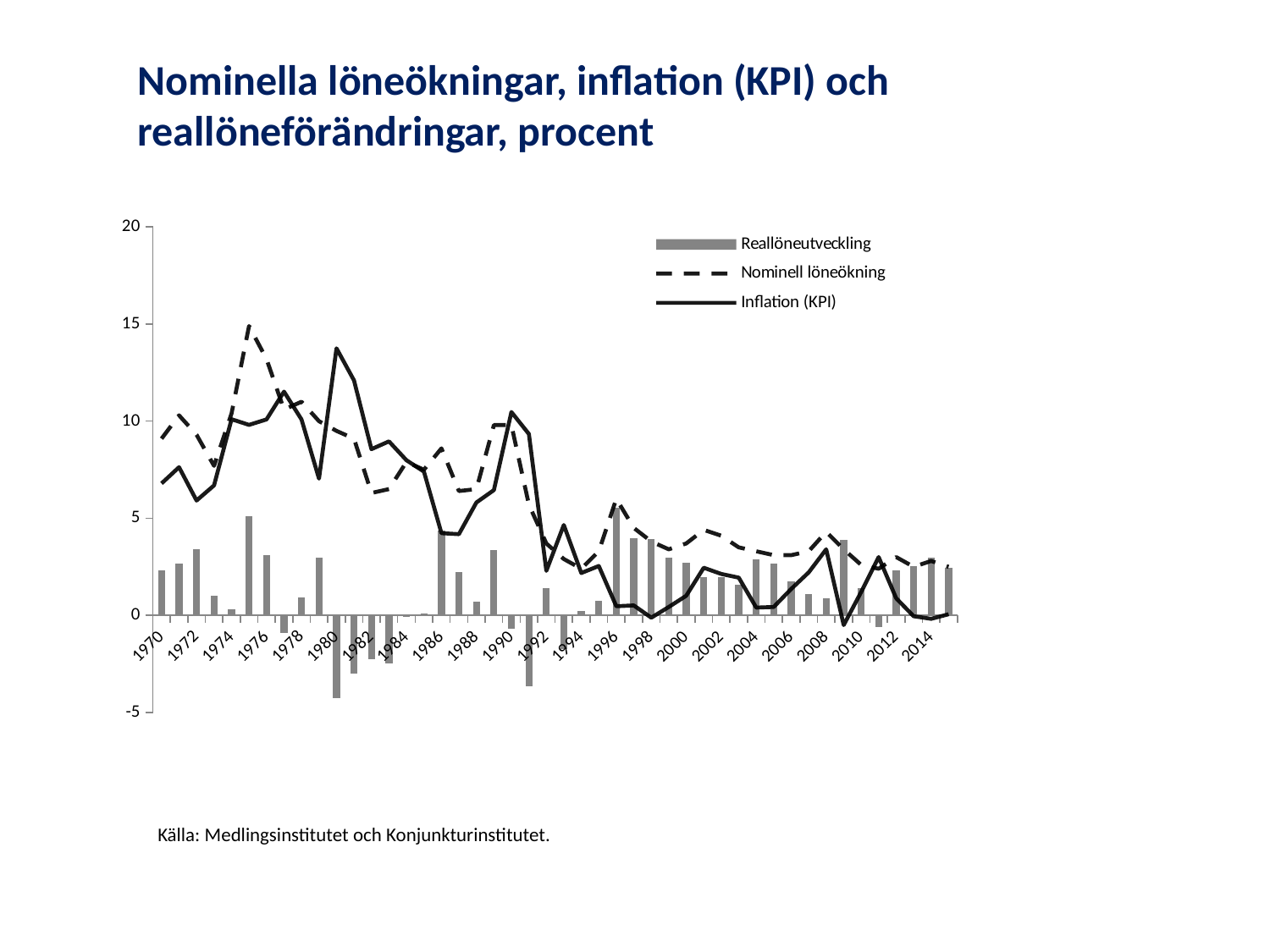
Which series is drawn with a dashed line? Nominell löneökning In which year does Nominell löneökning reach its highest value? 1975 Which series is drawn as bars? Reallöneutveckling Is the value of Inflation (KPI) in 1980 greater or less than 10? greater In which year does Inflation (KPI) reach its highest value? 1980 In 1980, which is higher: Inflation (KPI) or Nominell löneökning? Inflation (KPI) In which year is the Reallöneutveckling bar the highest? 1996 Is the value of Nominell löneökning in 1975 greater or less than 10? greater How many series does the legend list? 3 Is the Reallöneutveckling value for 1980 greater or less than 0? less What kind of chart is shown on the slide? A combined bar and line chart Does Nominell löneökning generally rise or fall from 1975 to 2014? fall